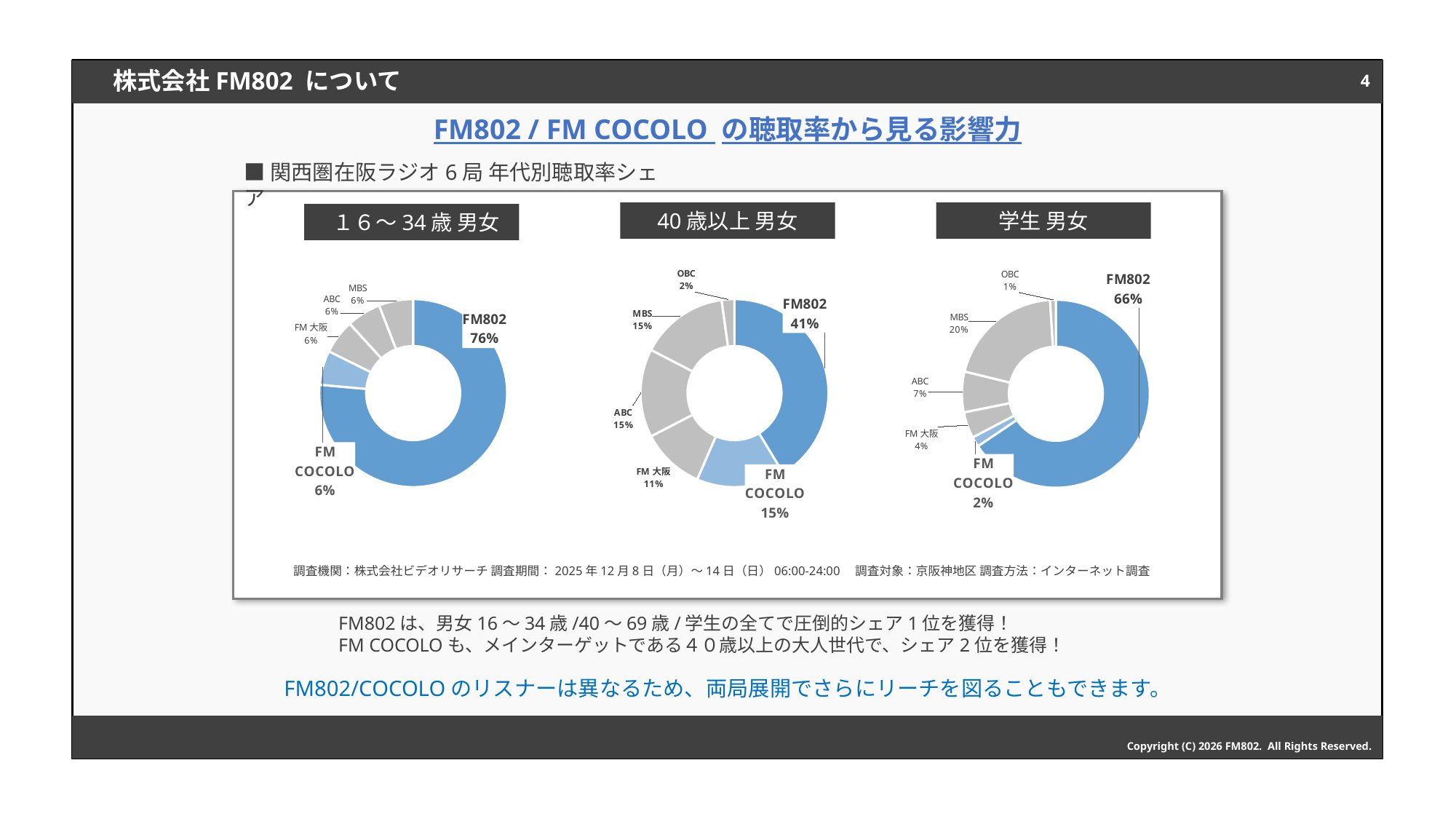
What kind of chart is used for the 16～34歳 男女 data? Donut (pie) chart How many slices does the 40歳以上 男女 chart have? 6 In the 学生 男女 chart, which station has the smallest share? OBC In the 学生 男女 chart, which is larger, the share for ABC or the share for FM大阪? ABC In the 40歳以上 男女 chart, which station has the smallest share? OBC In the 16～34歳 男女 chart, what share does FM802 have? 76% In the 40歳以上 男女 chart, what share does FM大阪 have? 11% In the 学生 男女 chart, what share does MBS have? 20% In the 40歳以上 男女 chart, what is the difference between FM802's share and FM COCOLO's share? 26% In the 学生 男女 chart, which station has the largest share? FM802 In the 学生 男女 chart, what is the difference between FM802's share and MBS's share? 46% In the 40歳以上 男女 chart, what share does FM COCOLO have? 15%